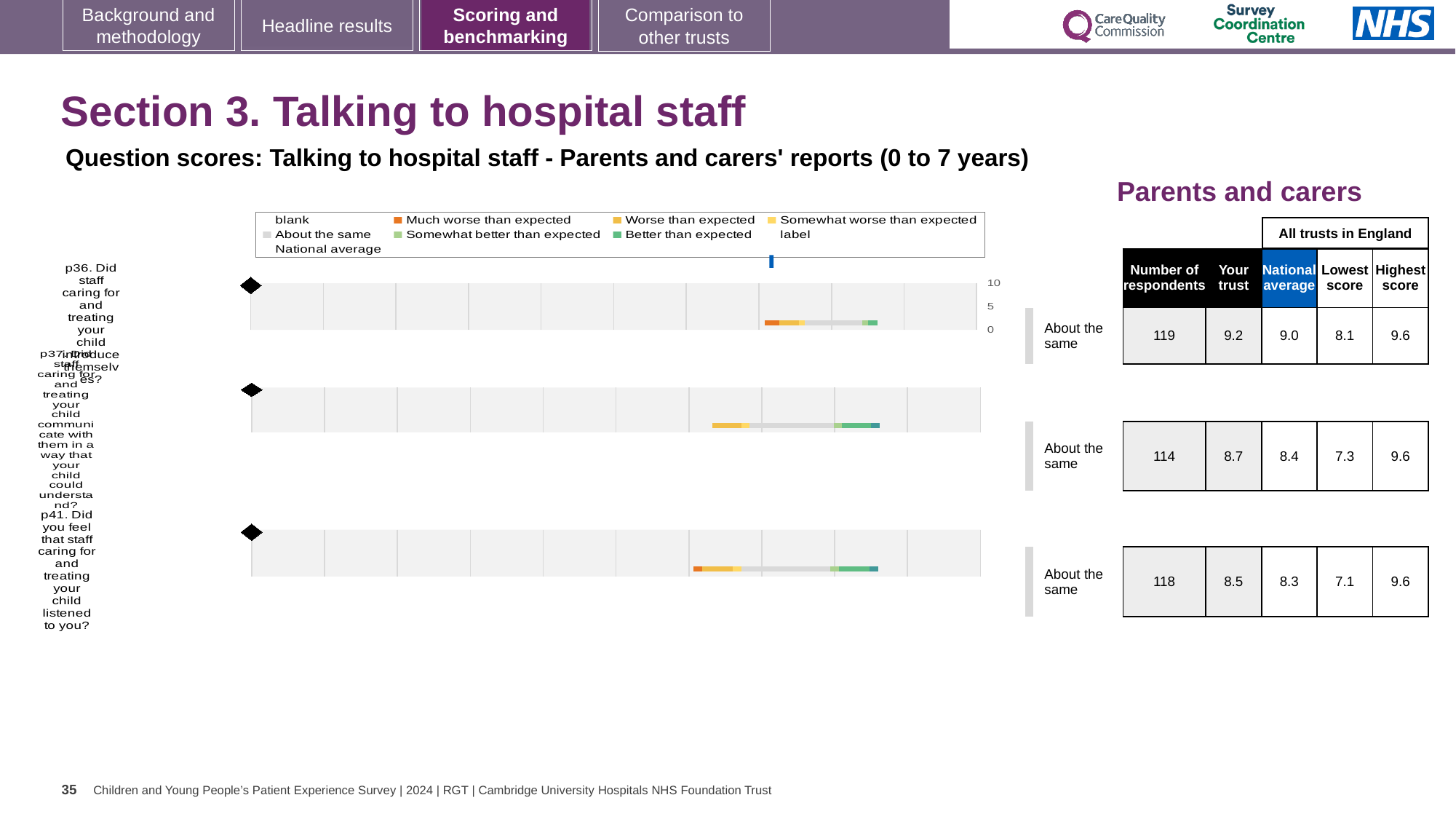
Which question has the lowest 'Your trust' score? p41 What is the highest score among all trusts in England for question p36? 9.6 What is the national average score for question p37 (Did staff communicate with your child in a way they could understand)? 8.4 What is the 'Your trust' score for question p36 (Did staff caring for and treating your child introduce themselves)? 9.2 What is the difference between the 'Your trust' score and the national average for question p36? 0.2 How many survey questions (categories) are plotted in the chart? 3 What is the lowest score among all trusts in England for question p41? 7.1 How many respondents answered question p41 (Did you feel that staff listened to you)? 118 For question p37, which is larger: the 'Your trust' score or the national average? Your trust Which question has the highest 'Your trust' score? p36 What benchmark label is shown next to the bar for question p36? About the same What kind of chart is used to show the question scores on this slide? bar chart